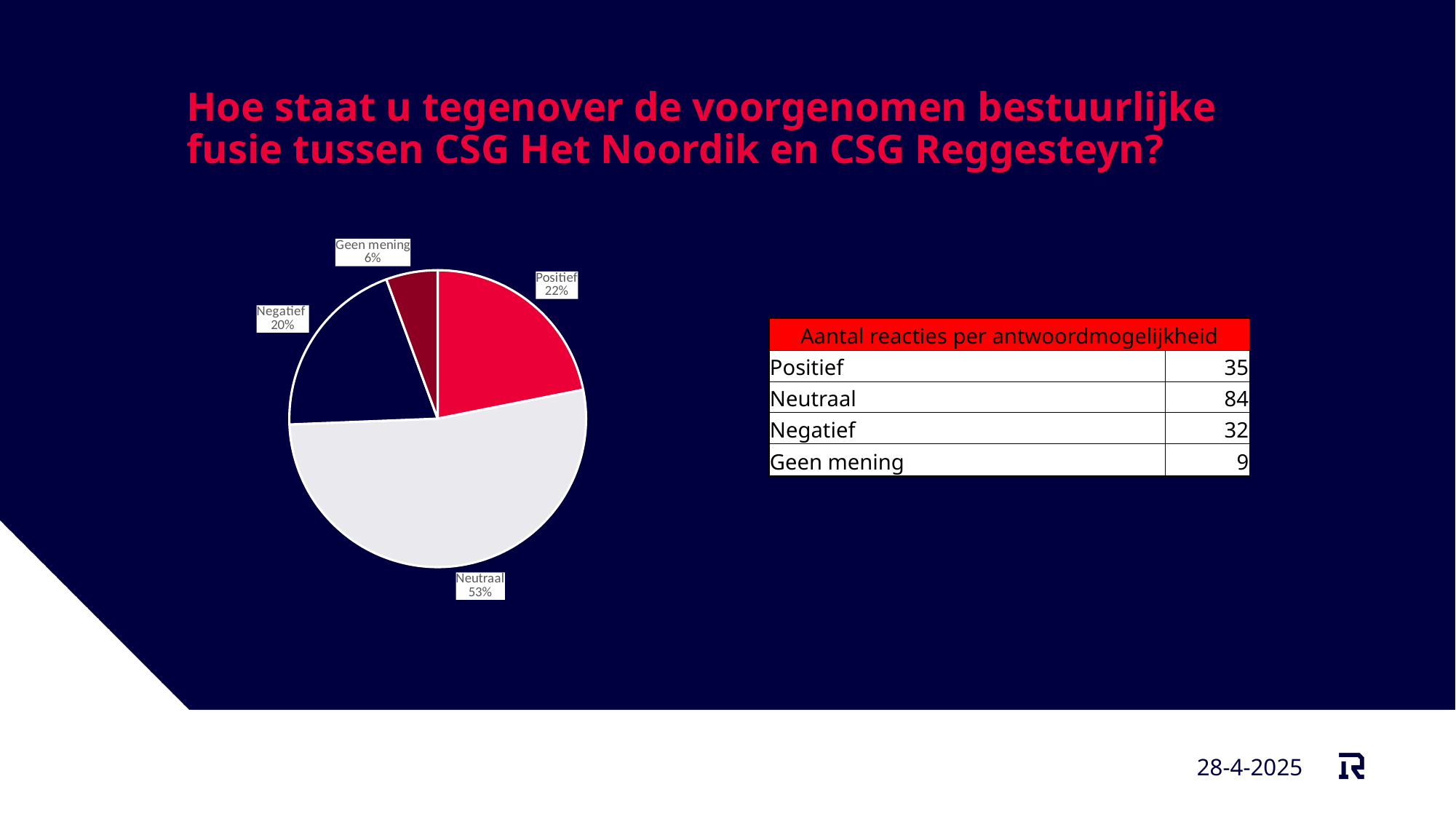
Which slice is larger, Positief or Negatief? Positief Which category has the largest slice of the pie? Neutraal What share of the pie does the Negatief slice represent? 20% How many slices does the pie chart have? 4 What share of the pie does the Geen mening slice represent? 6% What share of the pie does the Positief slice represent? 22% Which category has the smallest slice of the pie? Geen mening According to the table, how many responses were Neutraal? 84 What kind of chart is shown on the slide? Pie chart What is the difference in percentage points between the Neutraal and Positief slices? 31 percentage points What colour is the Neutraal slice of the pie? Light grey